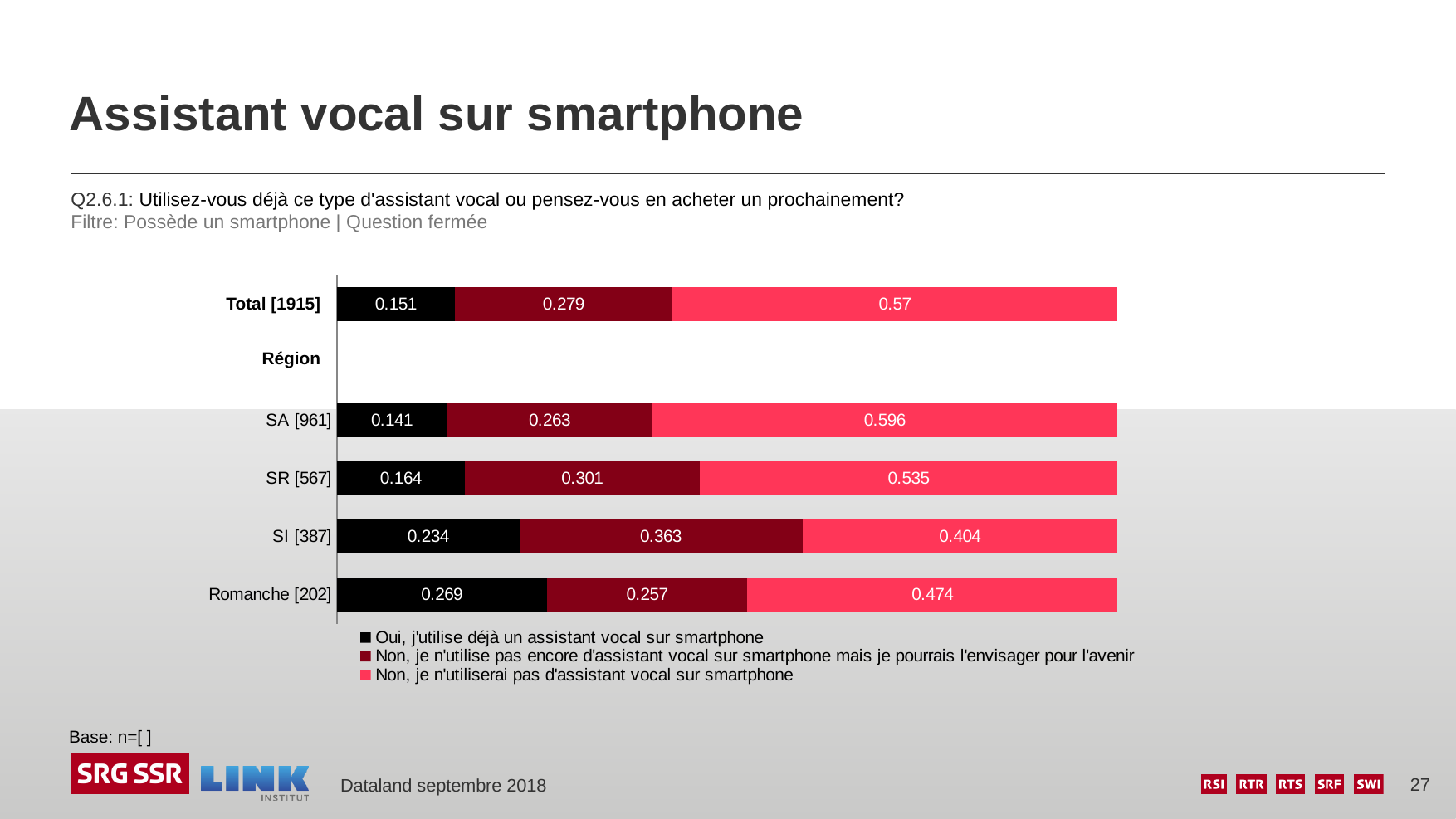
Which colour represents 'Oui, j'utilise déjà un assistant vocal sur smartphone' in the legend? Black Which category has the highest value for 'Oui, j'utilise déjà un assistant vocal sur smartphone'? Romanche [202] How many series does the legend list? 3 Which has the larger value for 'Oui, j'utilise déjà un assistant vocal sur smartphone', SA [961] or SR [567]? SR [567] Which category has the lowest value for 'Non, je n'utiliserai pas d'assistant vocal sur smartphone'? SI [387] What is the value for 'Non, je n'utiliserai pas d'assistant vocal sur smartphone' for SI [387]? 0.404 What is the value for 'Oui, j'utilise déjà un assistant vocal sur smartphone' in the Total [1915] bar? 0.151 What is the total of the three segments in the Romanche [202] bar? 1 How many bars are plotted in the chart? 5 What is the difference between the 'Non, je n'utiliserai pas d'assistant vocal sur smartphone' values for SA [961] and SI [387]? 0.192 What is the value for 'Non, je n'utilise pas encore d'assistant vocal sur smartphone mais je pourrais l'envisager pour l'avenir' for SR [567]? 0.301 What kind of chart is shown on the slide? Stacked bar chart